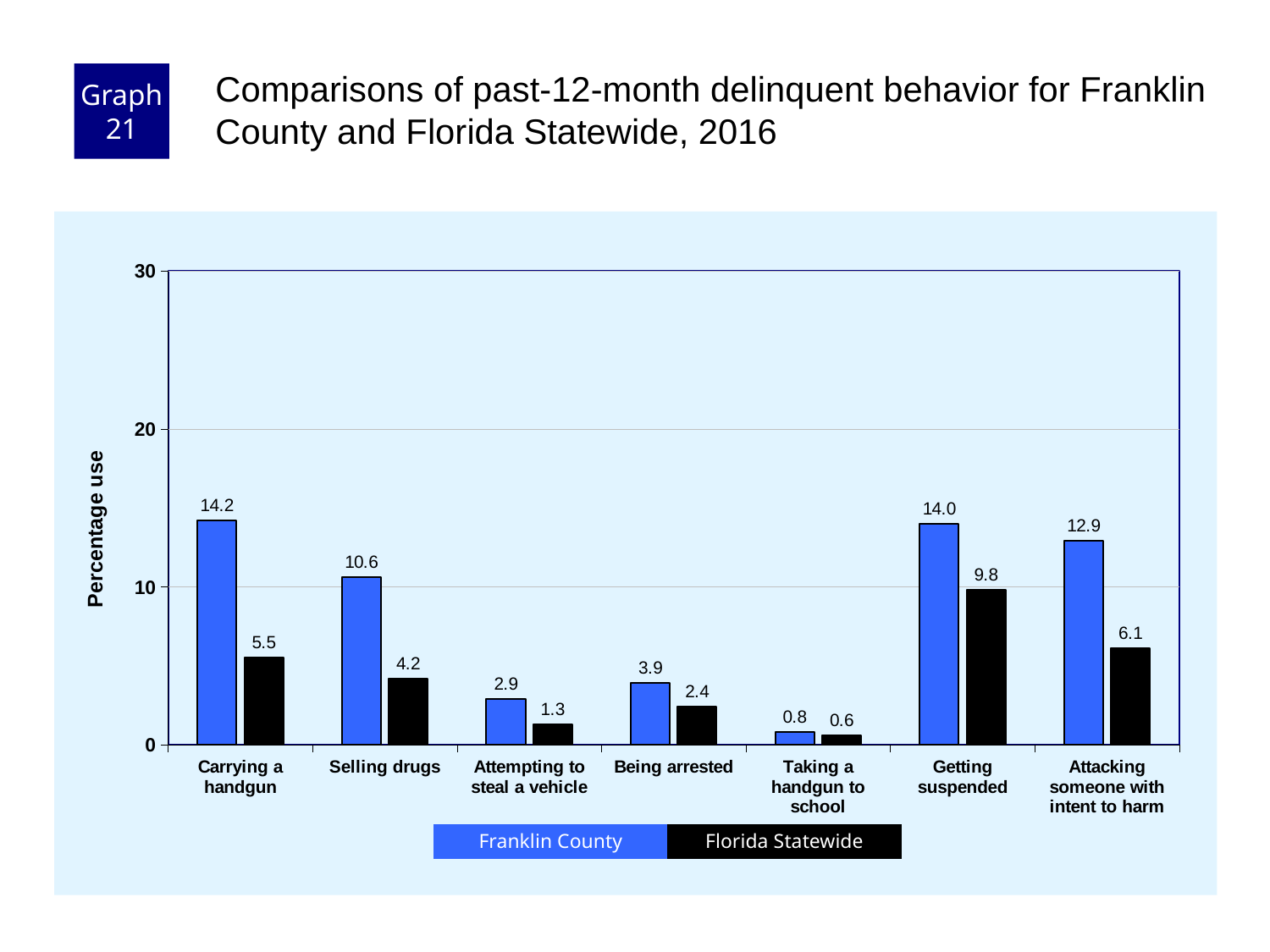
What is the Franklin County value for Carrying a handgun? 14.2 What is the Florida Statewide value for Getting suspended? 9.8 What kind of chart is shown on the slide? bar chart Which category has the highest Franklin County value? Carrying a handgun How many categories are shown on the x axis? 7 Is the Franklin County value for Getting suspended greater or less than 10? greater What is the label of the y axis? Percentage use How many series does the legend list? 2 Which category has the lowest Florida Statewide value? Taking a handgun to school What is the Franklin County value for Attacking someone with intent to harm? 12.9 Which is larger for Being arrested: the Franklin County value or the Florida Statewide value? Franklin County What is the difference between the Franklin County and Florida Statewide values for Selling drugs? 6.4